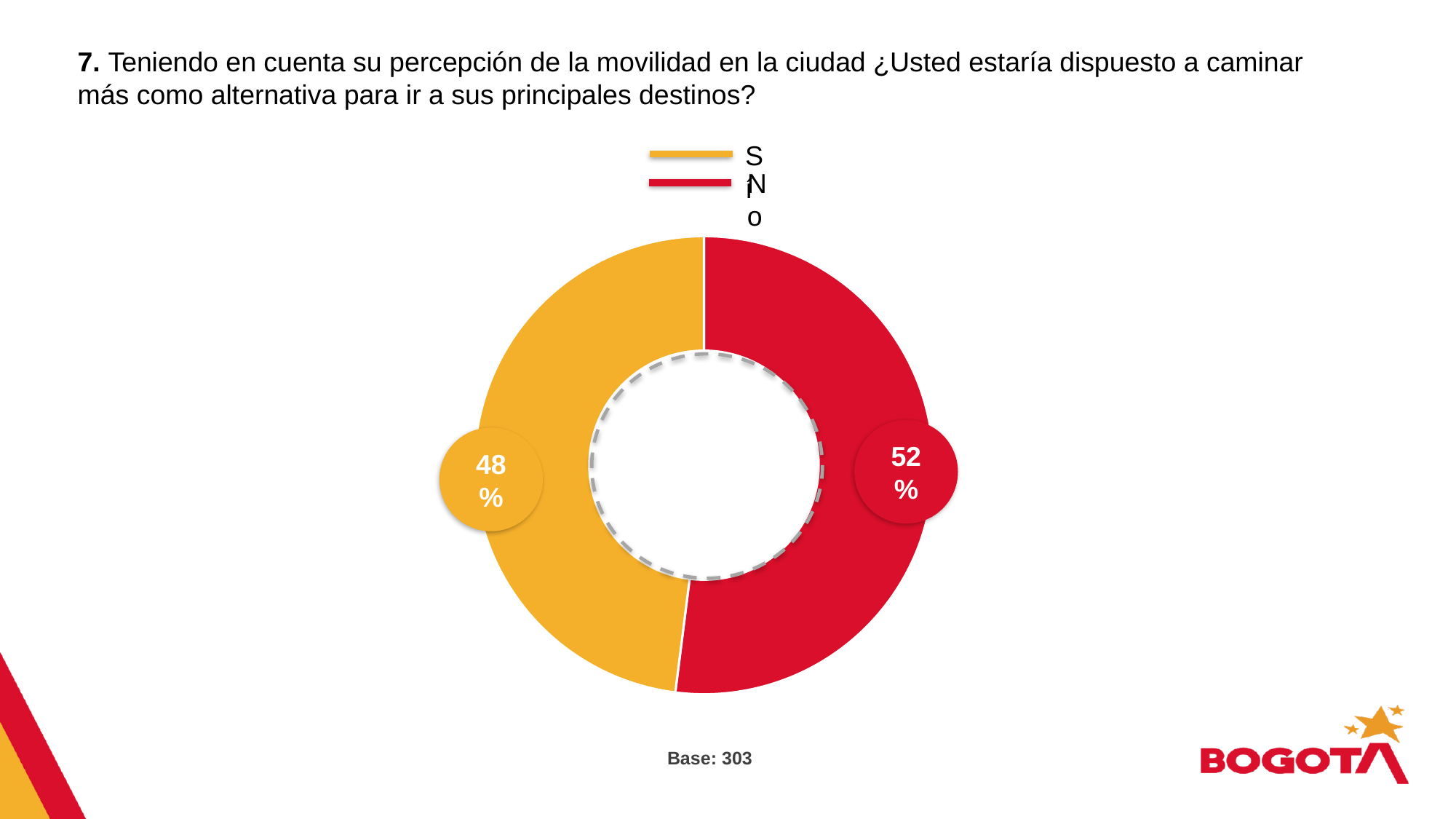
What is the difference in percentage points between the "No" and "Sí" shares? 4 percentage points Which response has the larger share, "Sí" or "No"? No What percentage of respondents answered "Sí"? 48% What colour represents the "Sí" response in the chart? Yellow What colour represents the "No" response in the chart? Red Which response has the smallest share in the chart? Sí How many entries does the legend list? 2 What kind of chart is shown on the slide? Pie chart (donut) How many slices does the chart have? 2 What is the base (number of respondents) shown below the chart? 303 Which response has the largest share in the chart? No What percentage of respondents answered "No"? 52%